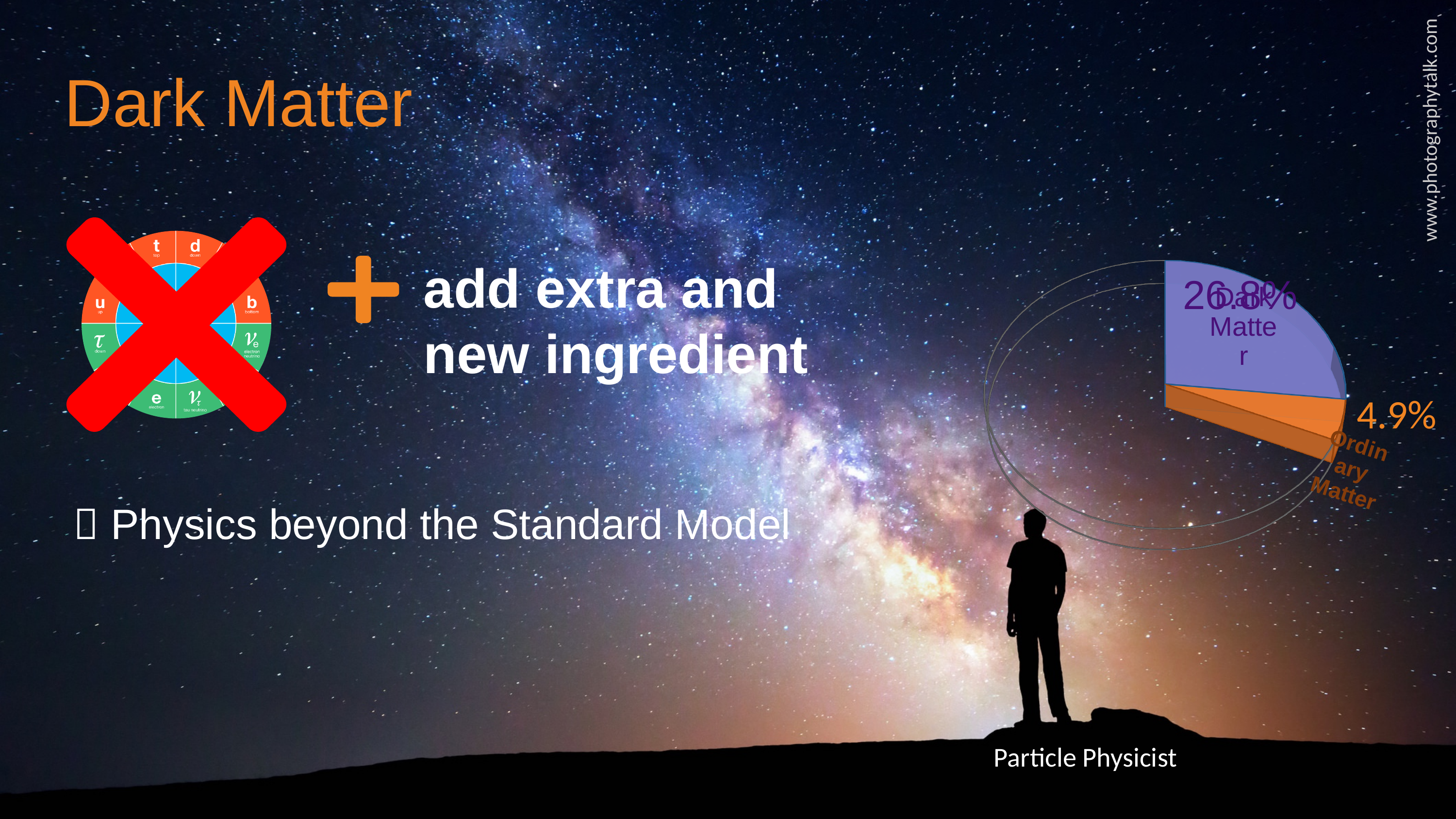
In the pie chart, what colour is the Ordinary Matter slice? orange In the pie chart, is the value for Dark Matter greater or less than 20%? greater In the pie chart, what percentage is shown for Ordinary Matter? 4.9% What kind of chart is shown on the right of the slide? pie chart In the pie chart, what percentage is shown for Dark Matter? 26.8% In the pie chart, is the value for Ordinary Matter greater or less than 10%? less In the pie chart, which slice is larger, Dark Matter or Ordinary Matter? Dark Matter In the pie chart, which labelled slice is the largest? Dark Matter In the pie chart, which labelled slice is the smallest? Ordinary Matter In the pie chart, what colour is the Dark Matter slice? purple